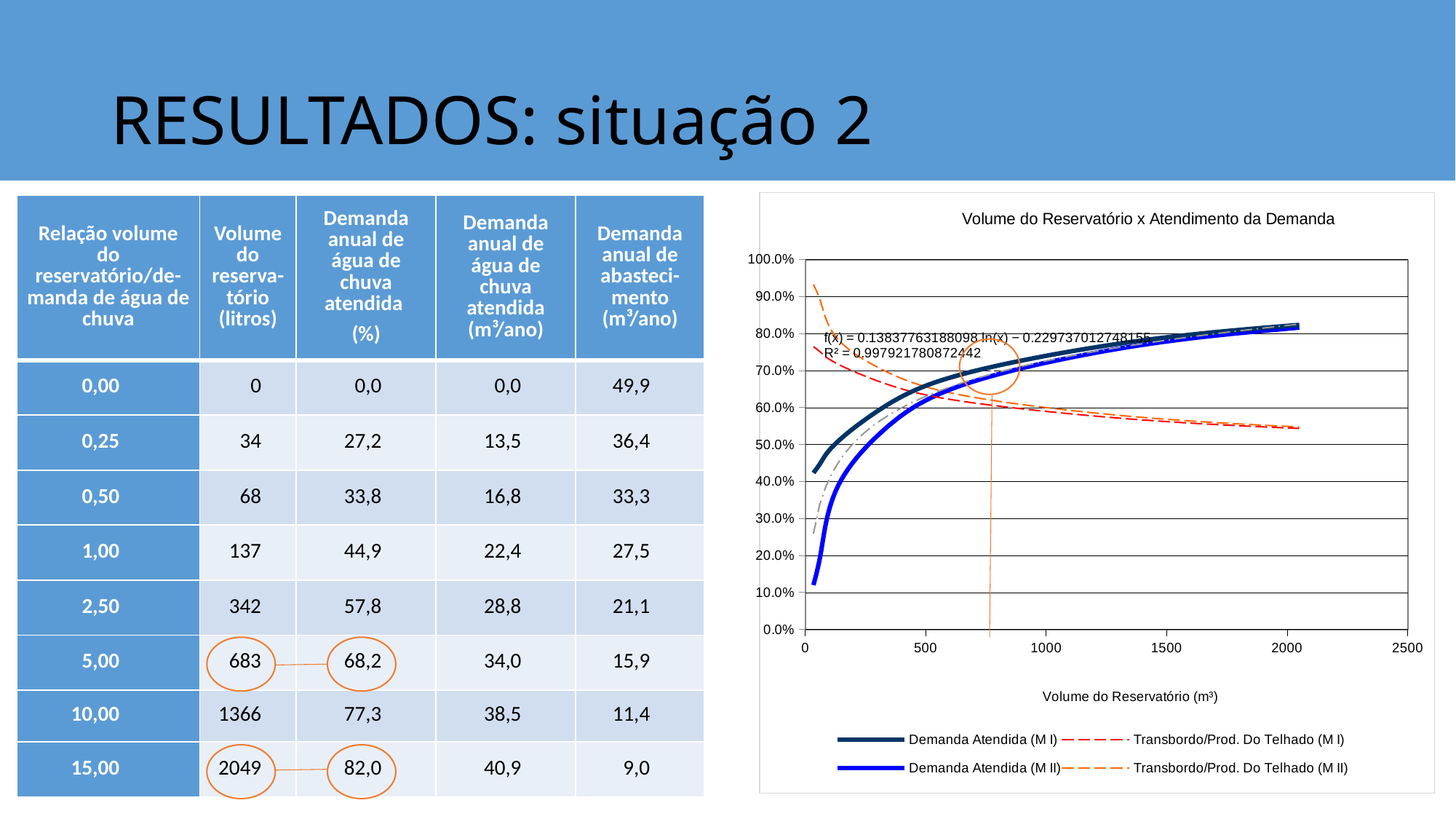
In the chart, is the starting value of the Transbordo/Prod. Do Telhado (M II) series (at the smallest volume) greater or less than 90.0%? greater What is the title of the chart on the slide? Volume do Reservatório x Atendimento da Demanda How many series does the chart's legend list? 4 What is the x-axis label of the chart? Volume do Reservatório (m³) In the chart, do the values of the Demanda Atendida (M I) series rise or fall as the reservoir volume increases? rise In the chart, is the value of the Transbordo/Prod. Do Telhado (M I) series at a volume of 2000 greater or less than 60.0%? less What R² value is printed on the chart? 0.997921780872442 In the chart, is the value of the Demanda Atendida (M I) series at a volume of 1500 greater or less than 70.0%? greater In the chart, do the values of the Transbordo/Prod. Do Telhado (M II) series rise or fall as the reservoir volume increases? fall What kind of chart is shown on the right of the slide? line chart In the chart, at the smallest reservoir volume, which series has the larger value: Demanda Atendida (M I) or Demanda Atendida (M II)? Demanda Atendida (M I)